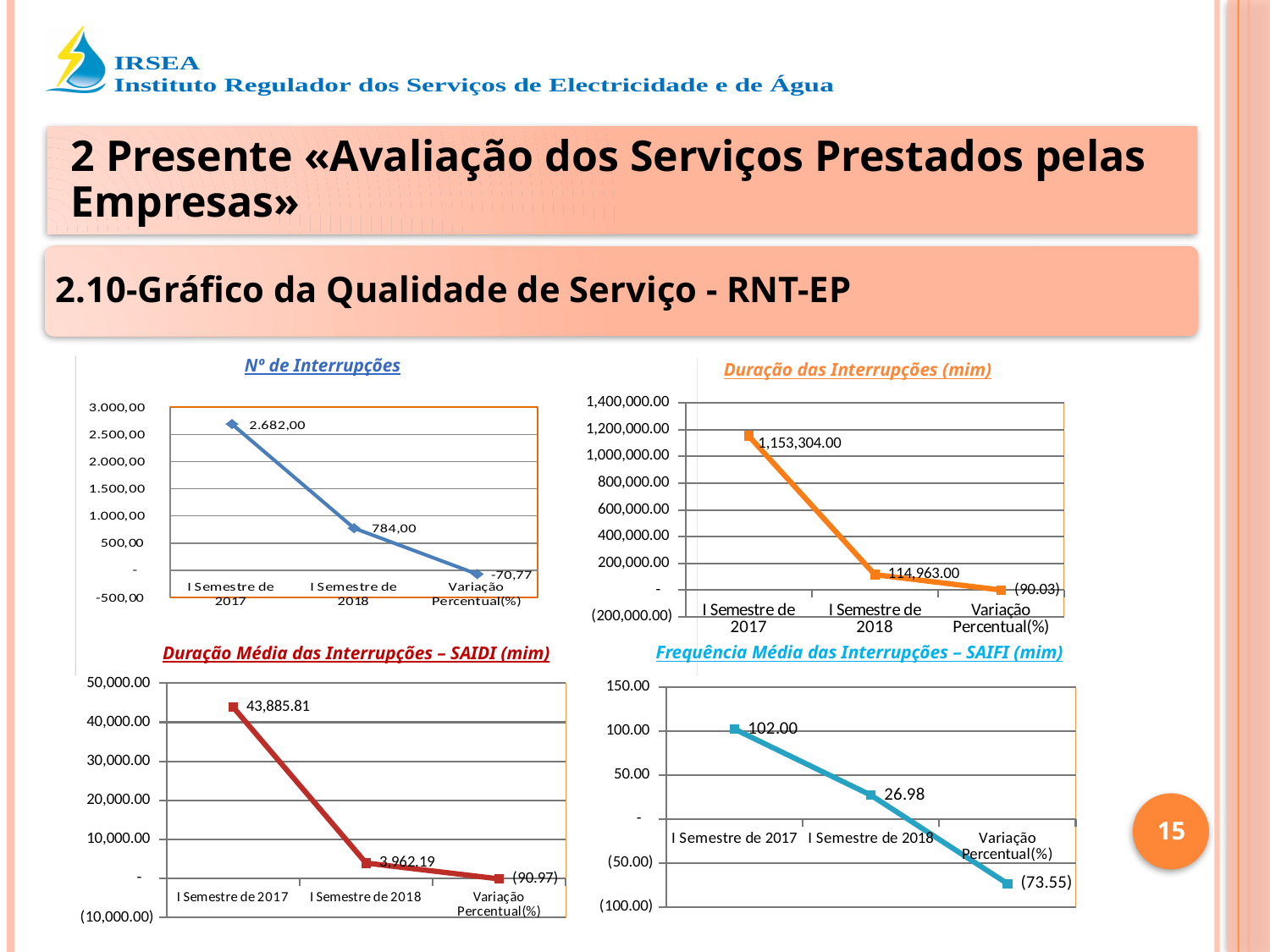
In the 'Nº de Interrupções' chart, what is the value for I Semestre de 2018? 784,00 In the 'Frequência Média das Interrupções – SAIFI (mim)' chart, what is the difference between the I Semestre de 2017 and I Semestre de 2018 values? 75.02 In the 'Duração Média das Interrupções – SAIDI (mim)' chart, what is the Variação Percentual(%) value? (90.97) In the 'Nº de Interrupções' chart, which category has the highest value? I Semestre de 2017 In the 'Nº de Interrupções' chart, what is the Variação Percentual(%) value? -70,77 In the 'Duração Média das Interrupções – SAIDI (mim)' chart, what is the value for I Semestre de 2017? 43,885.81 What kind of chart is the 'Frequência Média das Interrupções – SAIFI (mim)' chart? line chart In the 'Nº de Interrupções' chart, what is the value for I Semestre de 2017? 2.682,00 In the 'Duração das Interrupções (mim)' chart, what is the value for I Semestre de 2018? 114,963.00 In the 'Duração Média das Interrupções – SAIDI (mim)' chart, do the values rise or fall from left to right along the x axis? fall In the 'Frequência Média das Interrupções – SAIFI (mim)' chart, what is the value for I Semestre de 2018? 26.98 In the 'Duração das Interrupções (mim)' chart, what is the value for I Semestre de 2017? 1,153,304.00